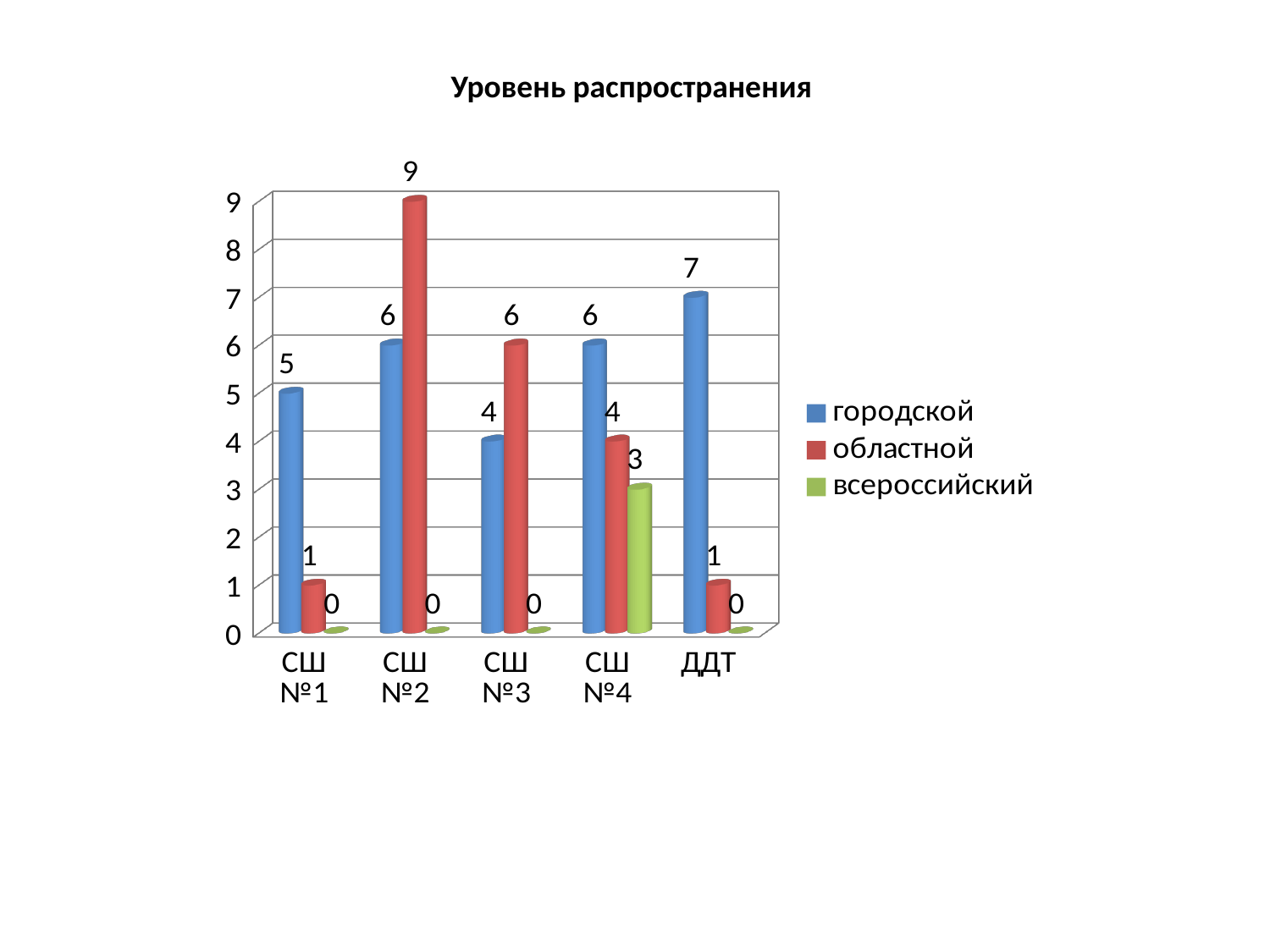
Which category has the lowest value for городской? СШ №3 How many series does the legend list? 3 What is the value for областной at СШ №3? 6 What is the value for всероссийский at СШ №4? 3 How many categories are shown on the x axis? 5 Which series is shown in green? всероссийский Which is larger at ДДТ: городской or областной? городской Which category has the highest value for областной? СШ №2 What is the title of the chart? Уровень распространения What is the difference between the областной value at СШ №2 and the городской value at СШ №2? 3 What is the value for городской at СШ №2? 6 What kind of chart is shown on the slide? bar chart